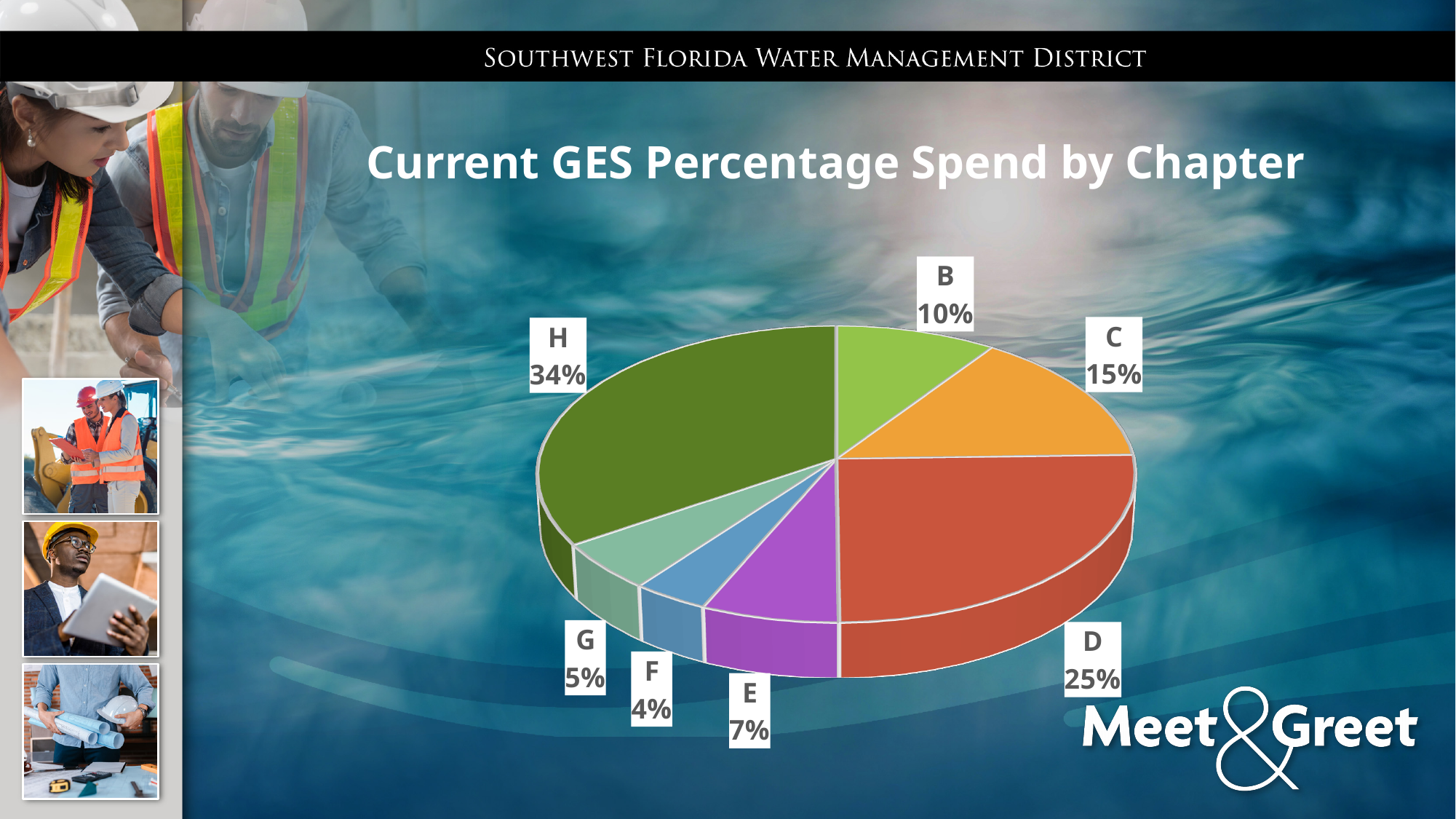
How many chapters are shown in the pie chart? 7 What percentage of spend is shown for chapter F? 4% What percentage of spend is shown for chapter H? 34% What kind of chart is shown on the slide? Pie chart What is the difference in percentage points between chapter H and chapter D? 9 What percentage of spend is shown for chapter D? 25% Which chapter has the largest share of spend? H What percentage of spend is shown for chapter C? 15% What is the title of the chart? Current GES Percentage Spend by Chapter Which chapter has a larger share of spend, B or E? B What colour is the slice for chapter D? Red Which chapter has the smallest share of spend? F